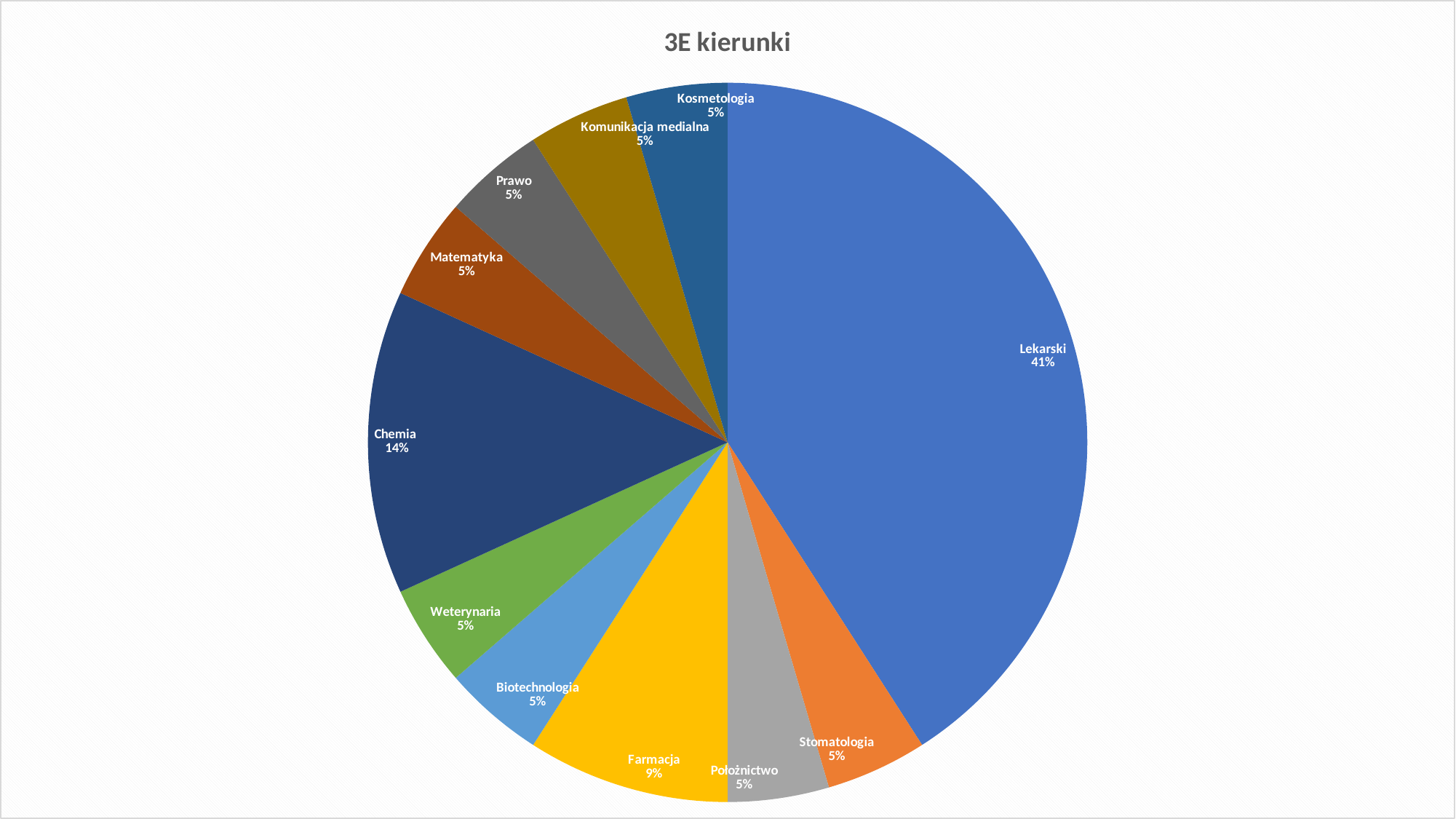
What is the value shown for Weterynaria? 5% What is the difference between the shares of Lekarski and Chemia? 27% Which is larger, Chemia or Farmacja? Chemia What share of the pie does Chemia have? 14% What is the difference between the shares of Farmacja and Stomatologia? 4% Which category has the largest slice of the pie? Lekarski How many slices does the pie chart have? 11 What is the title of the chart? 3E kierunki What type of chart is shown on the slide? Pie chart What is the value shown for Komunikacja medialna? 5% What share of the pie does Lekarski have? 41% What share of the pie does Farmacja have? 9%